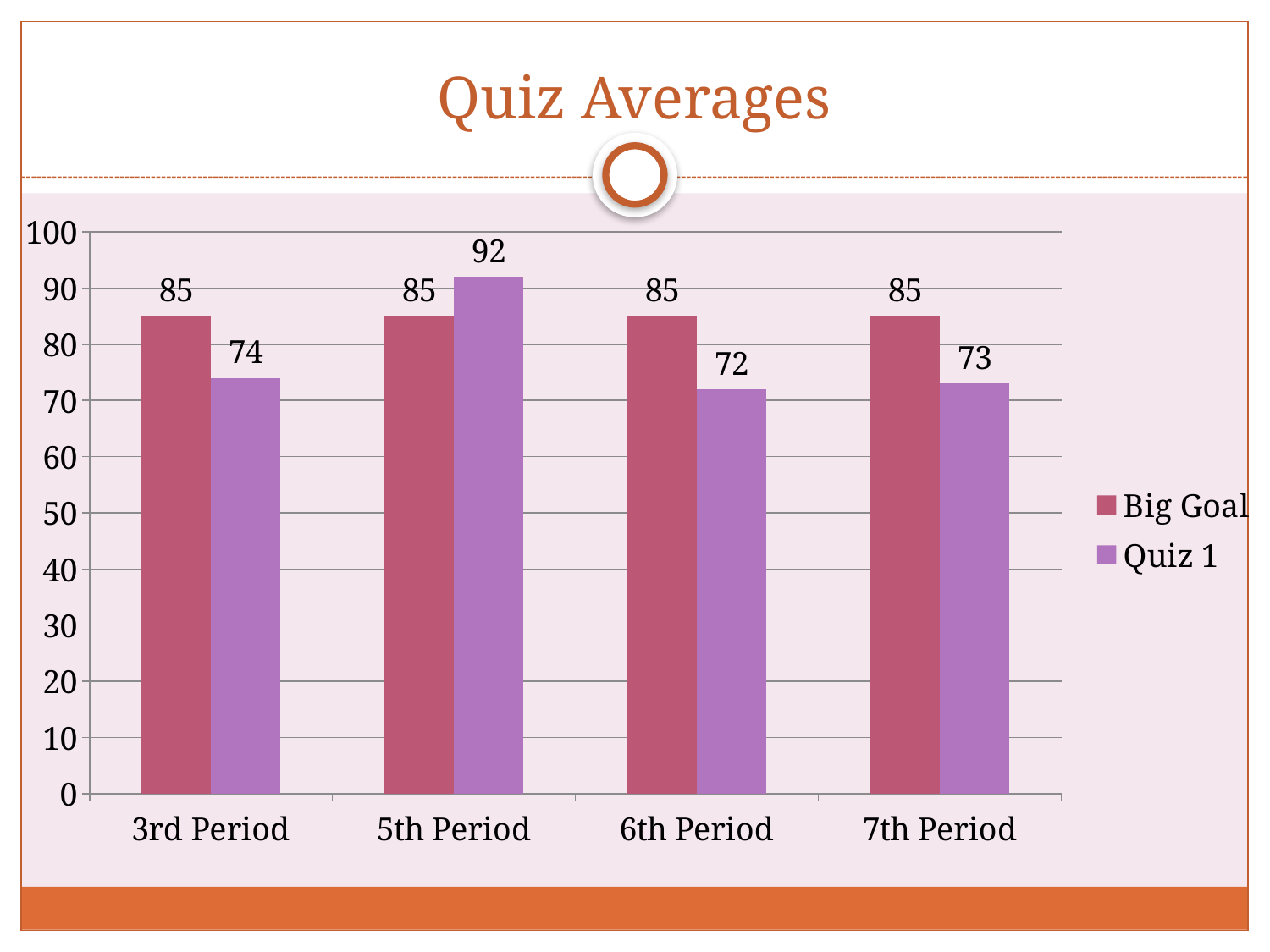
What is the Quiz 1 value for 5th Period? 92 How many series does the legend list? 2 Which period has the lowest Quiz 1 value? 6th Period Which is larger for 7th Period, Big Goal or Quiz 1? Big Goal How many periods are shown on the x axis? 4 What is the difference between the Big Goal and Quiz 1 values for 6th Period? 13 What is the Big Goal value for 6th Period? 85 What is the Quiz 1 value for 3rd Period? 74 What kind of chart is shown on the slide? bar chart Which period has the highest Quiz 1 value? 5th Period Is the Quiz 1 value for 3rd Period greater or less than 80? less What is the difference between the Quiz 1 value and the Big Goal value for 5th Period? 7